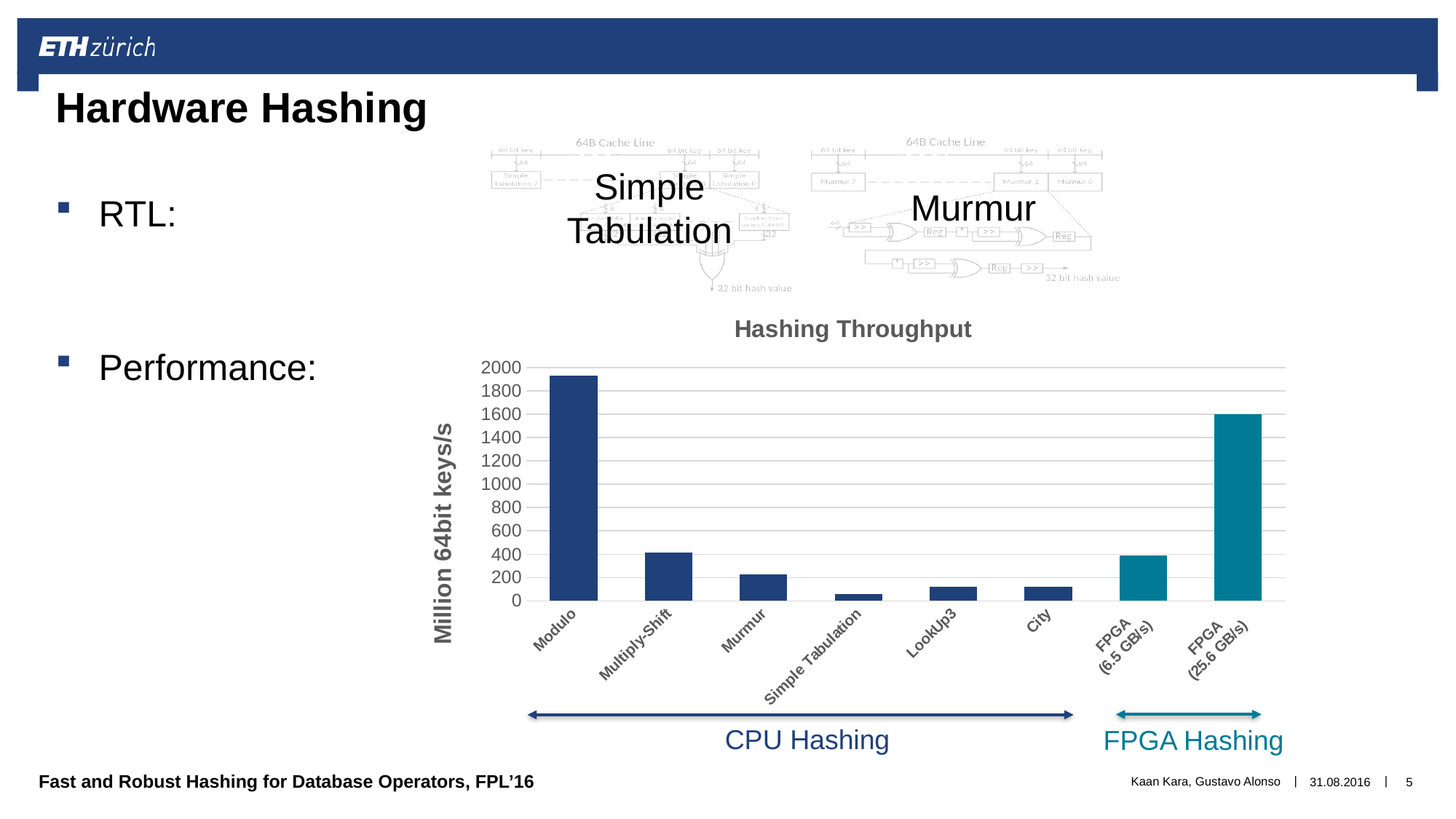
What is the title of the chart on the slide? Hashing Throughput Is the throughput for FPGA (25.6 GB/s) greater or less than 1400 million 64bit keys/s? greater What is the label of the vertical axis of the Hashing Throughput chart? Million 64bit keys/s Is the throughput for Modulo greater or less than 1800 million 64bit keys/s? greater Which hashing method has the lowest throughput in the Hashing Throughput chart? Simple Tabulation How many hashing methods (bars) are shown in the Hashing Throughput chart? 8 Which has higher throughput, FPGA (25.6 GB/s) or FPGA (6.5 GB/s)? FPGA (25.6 GB/s) Which has higher throughput, Multiply-Shift or Murmur? Multiply-Shift Is the throughput for Simple Tabulation greater or less than 200 million 64bit keys/s? less What kind of chart is the Hashing Throughput chart? bar chart Which hashing method has the highest throughput in the Hashing Throughput chart? Modulo